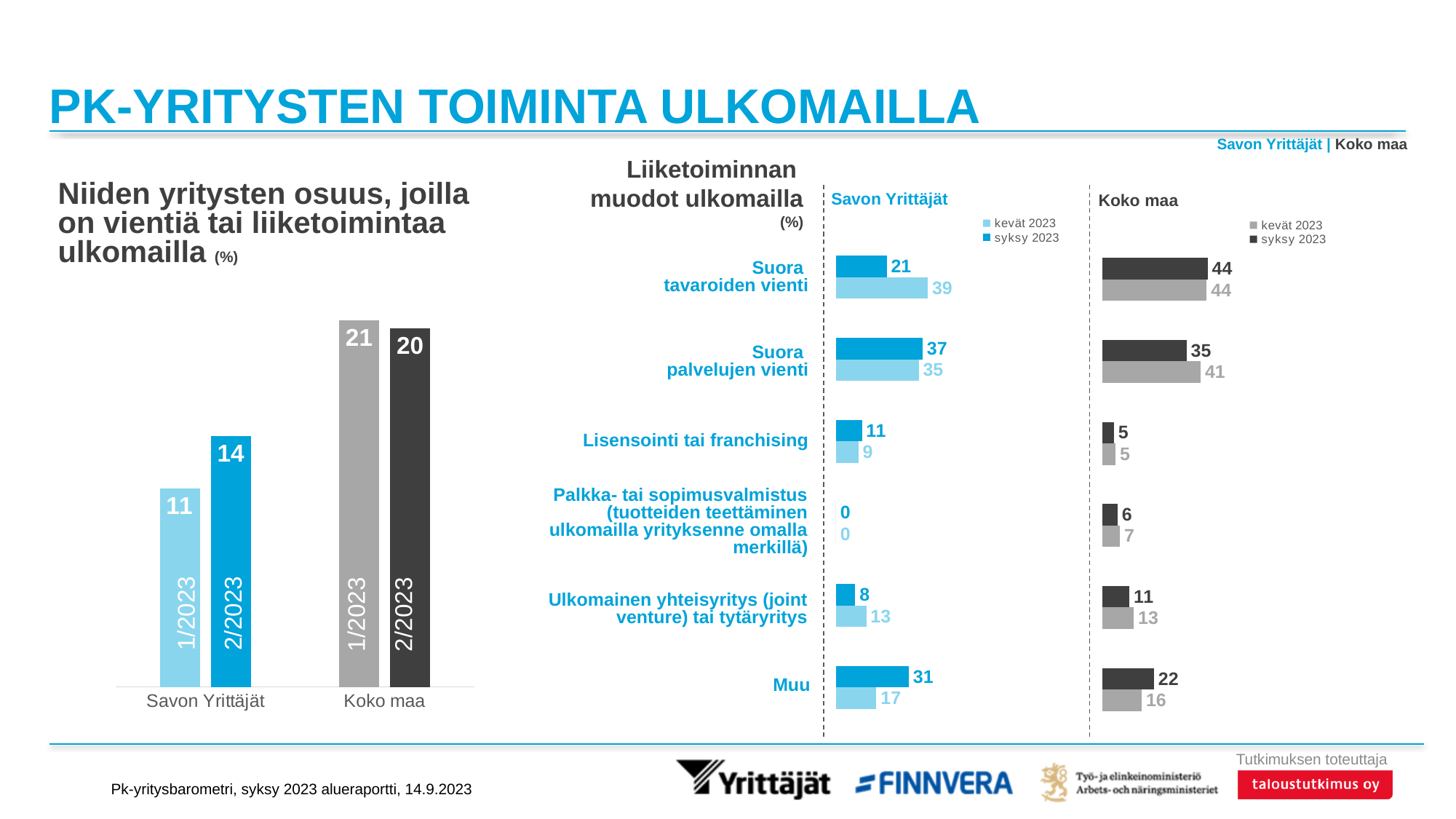
In the right chart 'Liiketoiminnan muodot ulkomailla', what is the difference between the kevät 2023 and syksy 2023 values for Suora palvelujen vienti for Koko maa? 6 How many categories are listed in the right chart 'Liiketoiminnan muodot ulkomailla'? 6 In the right chart 'Liiketoiminnan muodot ulkomailla', what is the kevät 2023 value for Suora tavaroiden vienti for Savon Yrittäjät? 39 What kind of chart is the left chart 'Niiden yritysten osuus, joilla on vientiä tai liiketoimintaa ulkomailla'? Bar chart In the left chart 'Niiden yritysten osuus, joilla on vientiä tai liiketoimintaa ulkomailla', what is the value for Koko maa in 1/2023? 21 In the left chart 'Niiden yritysten osuus, joilla on vientiä tai liiketoimintaa ulkomailla', what is the difference between the Koko maa 1/2023 value and the Savon Yrittäjät 1/2023 value? 10 In the left chart 'Niiden yritysten osuus, joilla on vientiä tai liiketoimintaa ulkomailla', what is the value for Savon Yrittäjät in 2/2023? 14 In the right chart 'Liiketoiminnan muodot ulkomailla', what is the syksy 2023 value for Muu for Koko maa? 22 How many series does the Savon Yrittäjät legend list in the right chart 'Liiketoiminnan muodot ulkomailla'? 2 In the right chart 'Liiketoiminnan muodot ulkomailla', which category has the lowest syksy 2023 value for Savon Yrittäjät? Palkka- tai sopimusvalmistus (tuotteiden teettäminen ulkomailla yrityksenne omalla merkillä) In the right chart 'Liiketoiminnan muodot ulkomailla', which is larger for Savon Yrittäjät in Muu: the syksy 2023 value or the kevät 2023 value? syksy 2023 In the left chart 'Niiden yritysten osuus, joilla on vientiä tai liiketoimintaa ulkomailla', which bar is the highest? Koko maa 1/2023